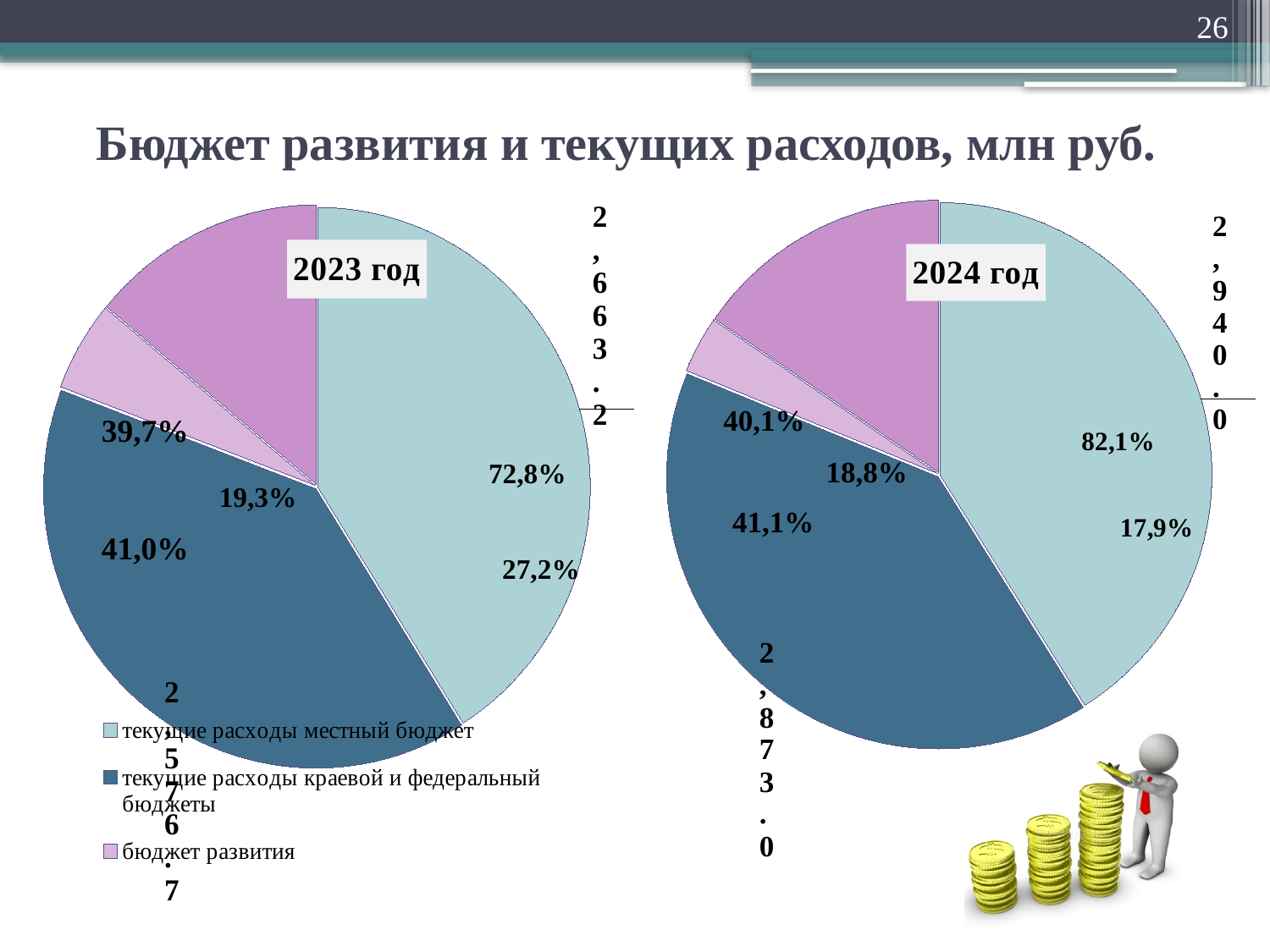
In the 2023 год chart, which legend category has the smallest slice? бюджет развития How many entries does the legend list? 3 In the 2024 год chart, which legend category has the smallest slice? бюджет развития In the 2023 год chart, which slice is larger: текущие расходы местный бюджет or бюджет развития? текущие расходы местный бюджет Which legend entry is shown in dark blue? текущие расходы краевой и федеральный бюджеты What kind of chart is the 2023 год chart? pie chart What is the title of the slide containing the two pie charts? Бюджет развития и текущих расходов, млн руб. How many pie charts are on the slide? 2 What kind of chart is the 2024 год chart? pie chart In the 2024 год chart, which slice is larger: текущие расходы краевой и федеральный бюджеты or бюджет развития? текущие расходы краевой и федеральный бюджеты